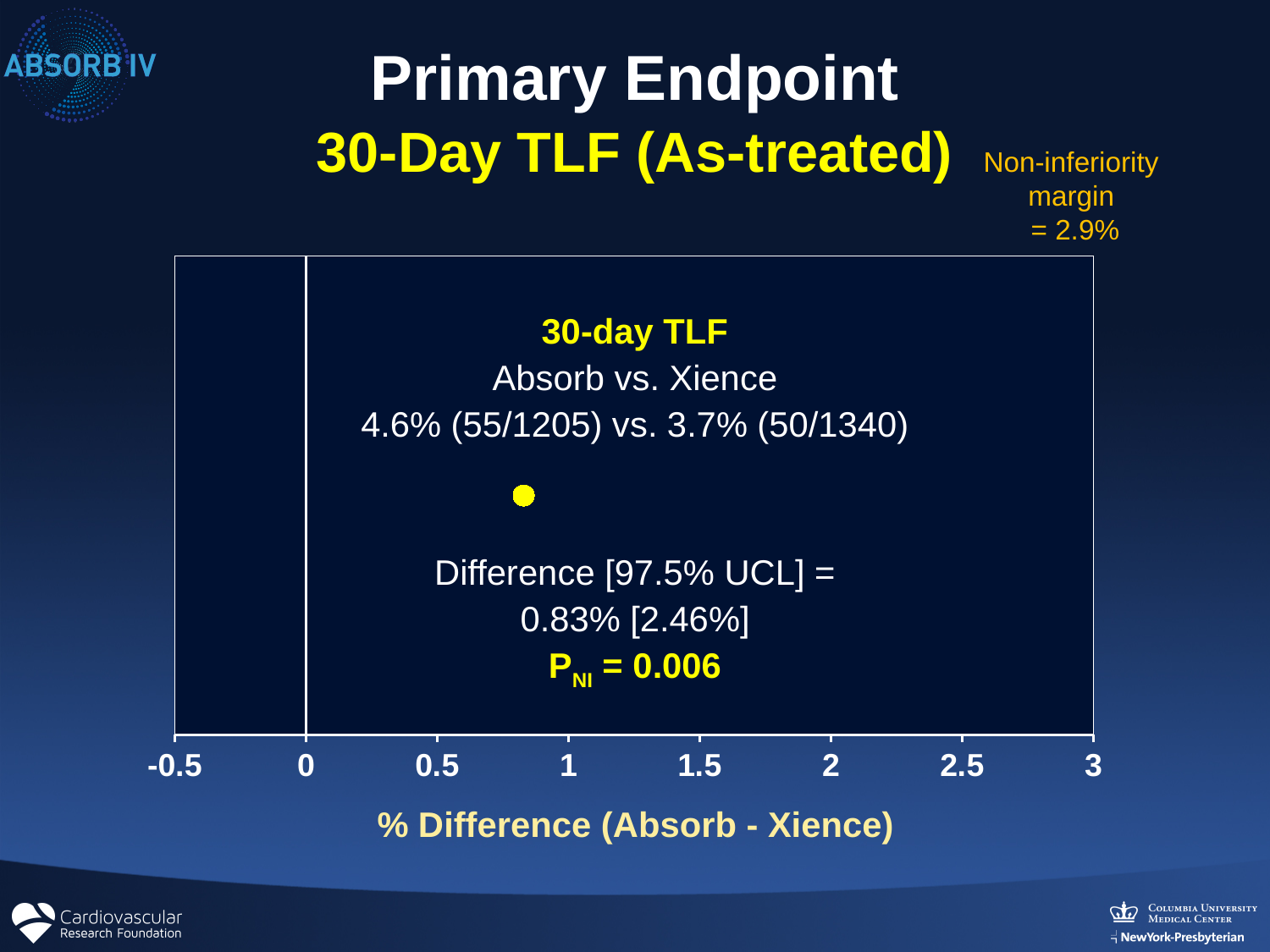
Which group has the higher 30-day TLF rate, Absorb or Xience? Absorb What is the label of the x axis? % Difference (Absorb - Xience) What is the 30-day TLF rate for Xience? 3.7% Is the plotted point estimate of the difference greater or less than 0.5 on the x axis? greater Is the plotted point estimate of the difference greater or less than 1 on the x axis? less How many patients were in the Absorb group for the 30-day TLF analysis? 1205 What is the non-inferiority p-value (P NI) shown on the chart? 0.006 How many TLF events occurred in the Xience group? 50 What is the non-inferiority margin stated on the slide? 2.9% What is the 97.5% upper confidence limit (UCL) of the difference? 2.46% What is the 30-day TLF rate for Absorb? 4.6% What is the difference in 30-day TLF between Absorb and Xience? 0.83%